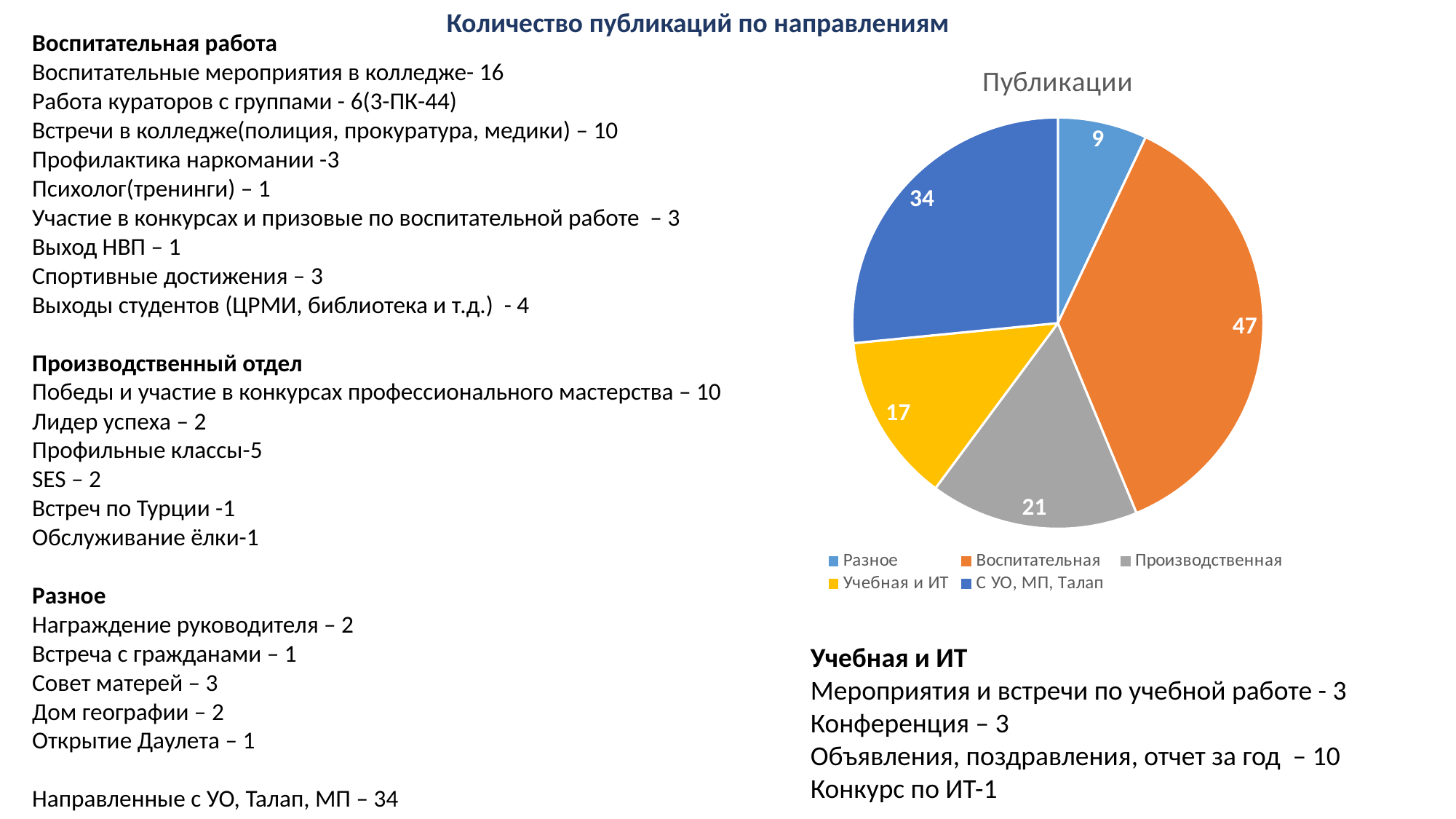
Which category has the largest slice in the pie chart? Воспитательная What is the title of the chart? Публикации What is the difference between the values for Воспитательная and Производственная? 26 Which category has the smallest slice in the pie chart? Разное Which legend entry is shown in orange? Воспитательная What is the value for Учебная и ИТ in the pie chart? 17 How many slices does the pie chart have? 5 What is the value for С УО, МП, Талап in the pie chart? 34 What type of chart is shown on the slide? pie chart Which is larger: Производственная or Учебная и ИТ? Производственная What is the value for Воспитательная in the pie chart? 47 What is the total of all slices in the pie chart? 128